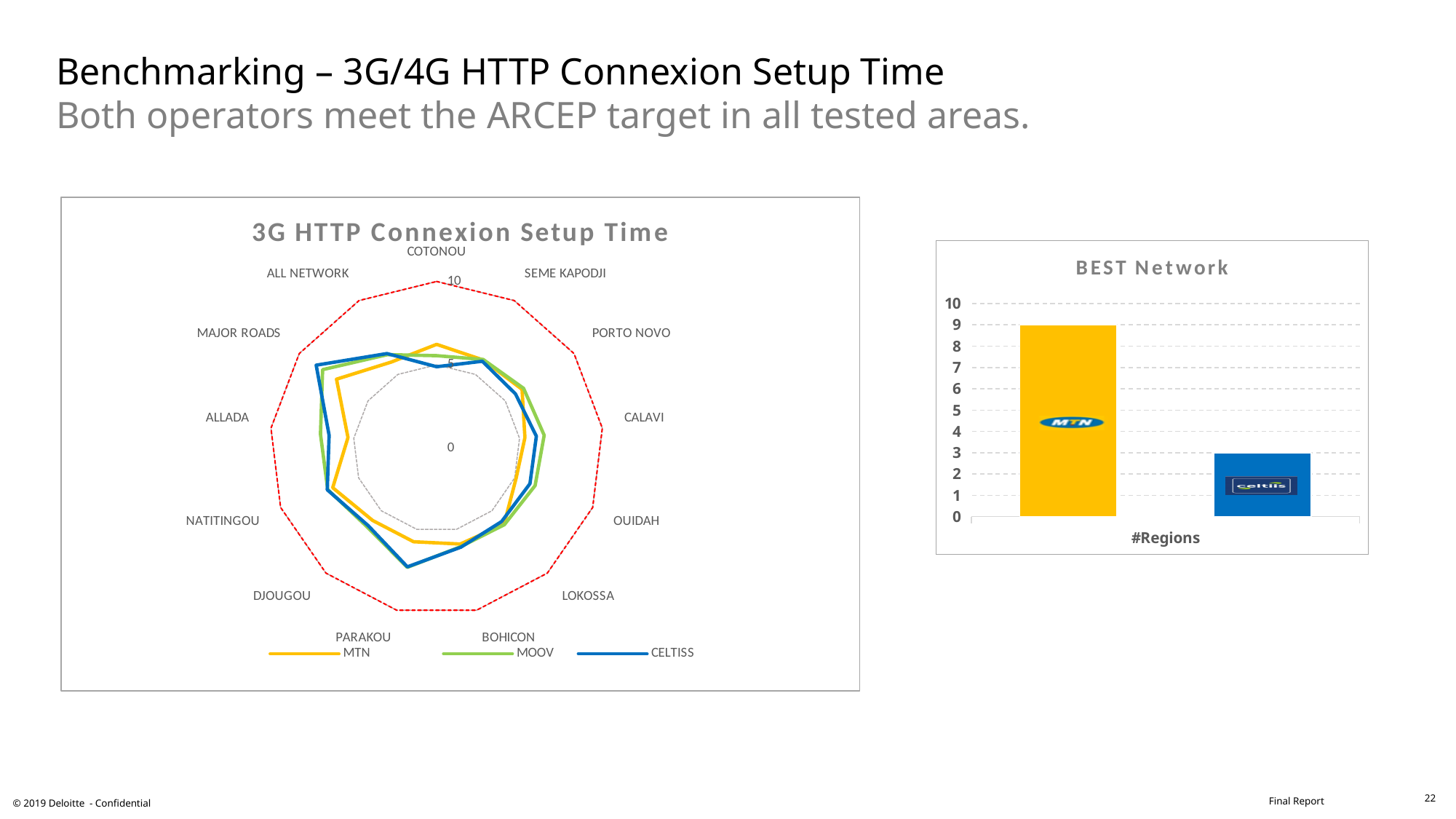
Which operators are listed in the legend of the "3G HTTP Connexion Setup Time" chart? MTN, MOOV, CELTISS In the "BEST Network" chart, which operator has the higher number of regions? MTN In the "BEST Network" chart, what is the number of regions for Celtis? 3 In the "3G HTTP Connexion Setup Time" chart, is the value for CELTISS at DJOUGOU greater or less than 5? greater What is the x-axis label of the "BEST Network" chart? #Regions In the "BEST Network" chart, what is the difference between the MTN and Celtis values? 6 What kind of chart is the "BEST Network" chart on the right? bar chart How many categories (areas) are plotted around the "3G HTTP Connexion Setup Time" radar chart? 13 In the "3G HTTP Connexion Setup Time" chart, is the value for MOOV at CALAVI greater or less than 10? less What kind of chart is the "3G HTTP Connexion Setup Time" chart on the left? radar chart How many series does the legend of the "3G HTTP Connexion Setup Time" chart list? 3 In the "BEST Network" chart, what is the number of regions for MTN? 9